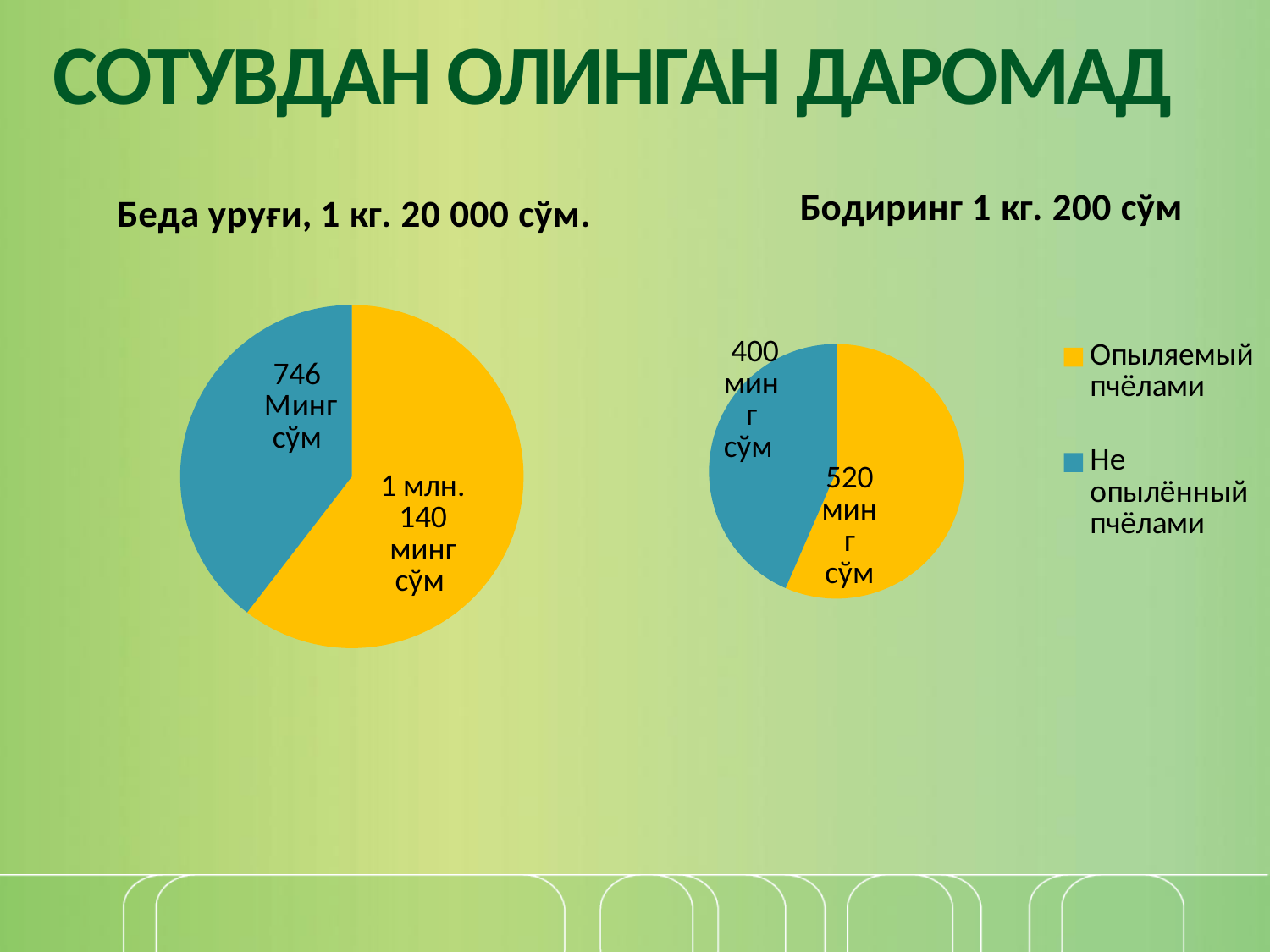
In the 'Бодиринг 1 кг. 200 сўм' chart, what is the value for 'Опыляемый пчёлами'? 520 минг сўм Which colour represents 'Не опылённый пчёлами' in the pie charts? Blue In the 'Бодиринг 1 кг. 200 сўм' chart, which slice is the largest? Опыляемый пчёлами How many entries does the legend on the slide list? 2 In the 'Беда уруғи, 1 кг. 20 000 сўм.' chart, what is the value for 'Не опылённый пчёлами'? 746 Минг сўм In the 'Бодиринг 1 кг. 200 сўм' chart, what is the difference between 'Опыляемый пчёлами' and 'Не опылённый пчёлами'? 120 минг сўм In the 'Беда уруғи, 1 кг. 20 000 сўм.' chart, which is larger: 'Опыляемый пчёлами' or 'Не опылённый пчёлами'? Опыляемый пчёлами What type of chart is used on the slide for 'Беда уруғи, 1 кг. 20 000 сўм.'? Pie chart In the 'Бодиринг 1 кг. 200 сўм' chart, what is the value for 'Не опылённый пчёлами'? 400 минг сўм In the 'Беда уруғи, 1 кг. 20 000 сўм.' chart, which slice is the smallest? Не опылённый пчёлами In the 'Беда уруғи, 1 кг. 20 000 сўм.' chart, what is the value for 'Опыляемый пчёлами'? 1 млн. 140 минг сўм How many slices does the 'Бодиринг 1 кг. 200 сўм' pie chart have? 2